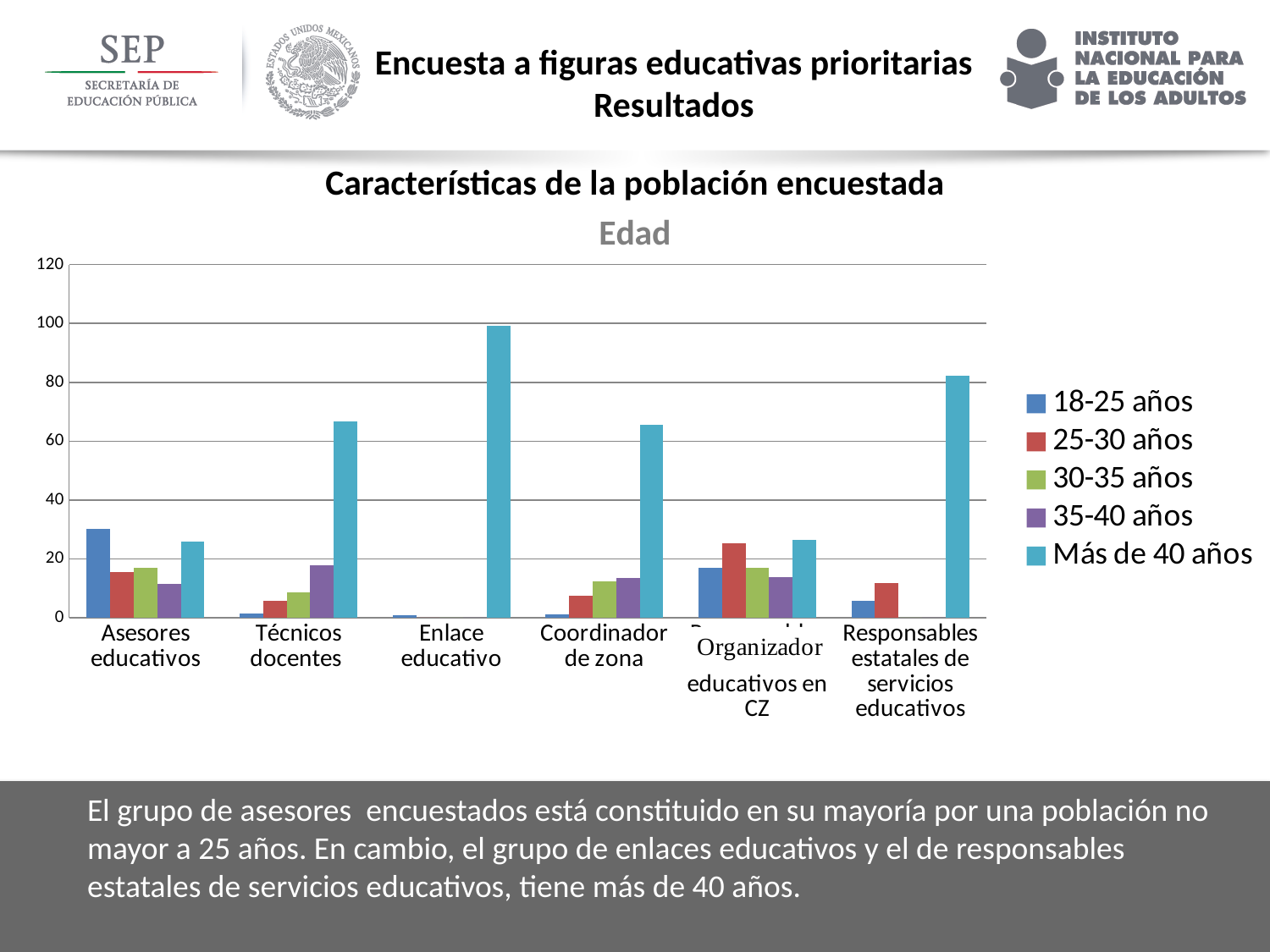
Is the "Más de 40 años" value for Responsables estatales de servicios educativos greater or less than 80? greater How many series does the legend of the "Edad" chart list? 5 Is the "Más de 40 años" value for Técnicos docentes greater or less than 80? less Is the "18-25 años" value for Asesores educativos greater or less than 20? greater How many categories are shown along the x axis of the "Edad" chart? 6 Which is larger for Asesores educativos: the "18-25 años" bar or the "35-40 años" bar? 18-25 años For the "18-25 años" series, which category has the highest bar? Asesores educativos What is the title shown directly above the chart? Edad Which is larger for Coordinador de zona: the "Más de 40 años" bar or the "25-30 años" bar? Más de 40 años What kind of chart is shown under the title "Edad"? bar chart For the "Más de 40 años" series, which category has the highest bar? Enlace educativo